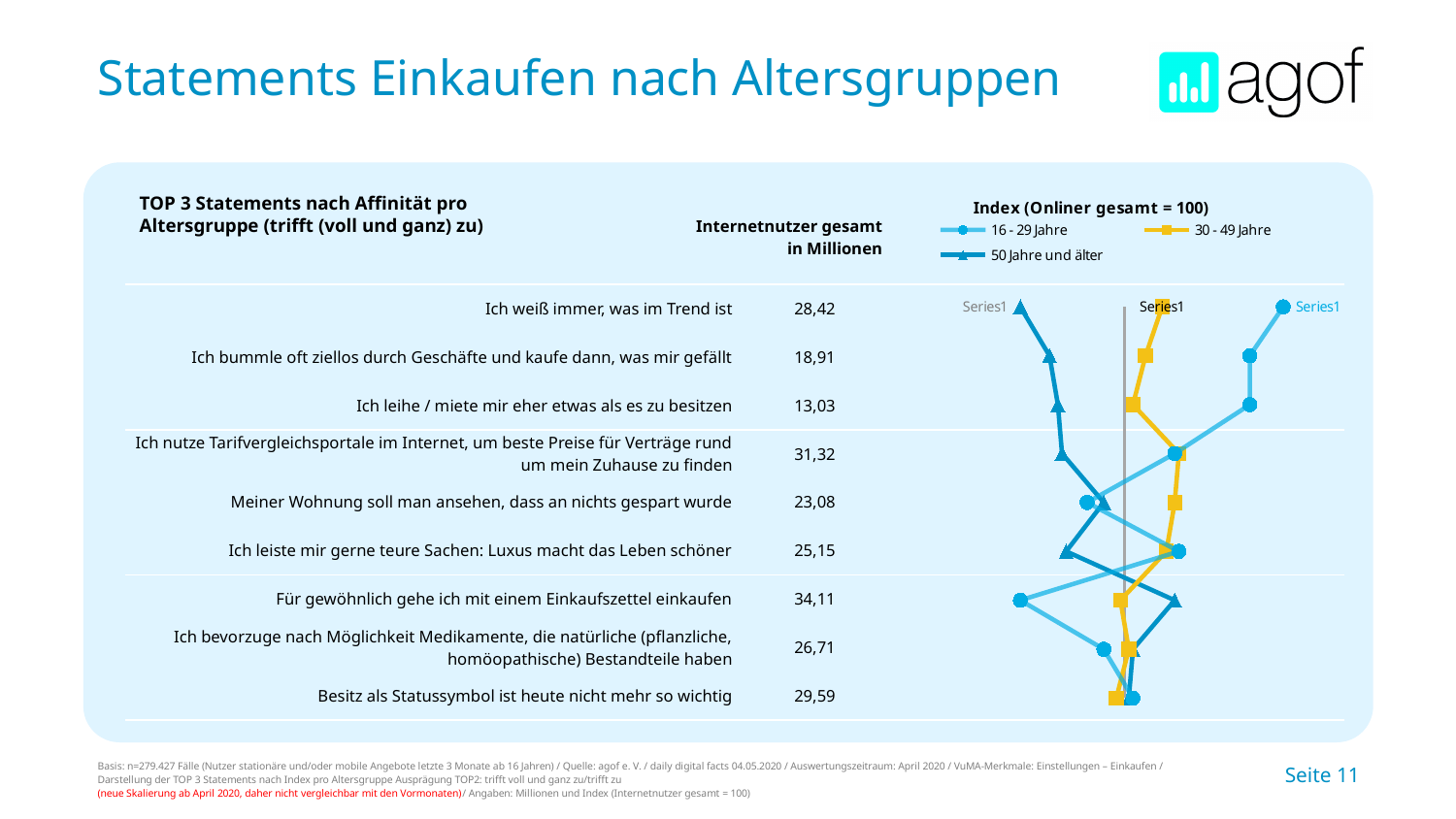
Which statement has the lowest value for 'Internetnutzer gesamt in Millionen'? Ich leihe / miete mir eher etwas als es zu besitzen What kind of chart is shown on the right side of the slide? line chart For the statement 'Für gewöhnlich gehe ich mit einem Einkaufszettel einkaufen', which age group has the lowest index value? 16 - 29 Jahre Is the index value for 50 Jahre und älter for the statement 'Für gewöhnlich gehe ich mit einem Einkaufszettel einkaufen' greater or less than 100? greater For the statement 'Ich weiß immer, was im Trend ist', which age group has the highest index value? 16 - 29 Jahre How many statements are plotted in the chart? 9 Which age groups are listed in the chart legend? 16 - 29 Jahre, 30 - 49 Jahre, 50 Jahre und älter Is the index value for 50 Jahre und älter for the statement 'Ich weiß immer, was im Trend ist' greater or less than 100? less How many series does the chart legend list? 3 Is the index value for 16 - 29 Jahre for the statement 'Für gewöhnlich gehe ich mit einem Einkaufszettel einkaufen' greater or less than 100? less What is the value for 'Internetnutzer gesamt in Millionen' for the statement 'Für gewöhnlich gehe ich mit einem Einkaufszettel einkaufen'? 34,11